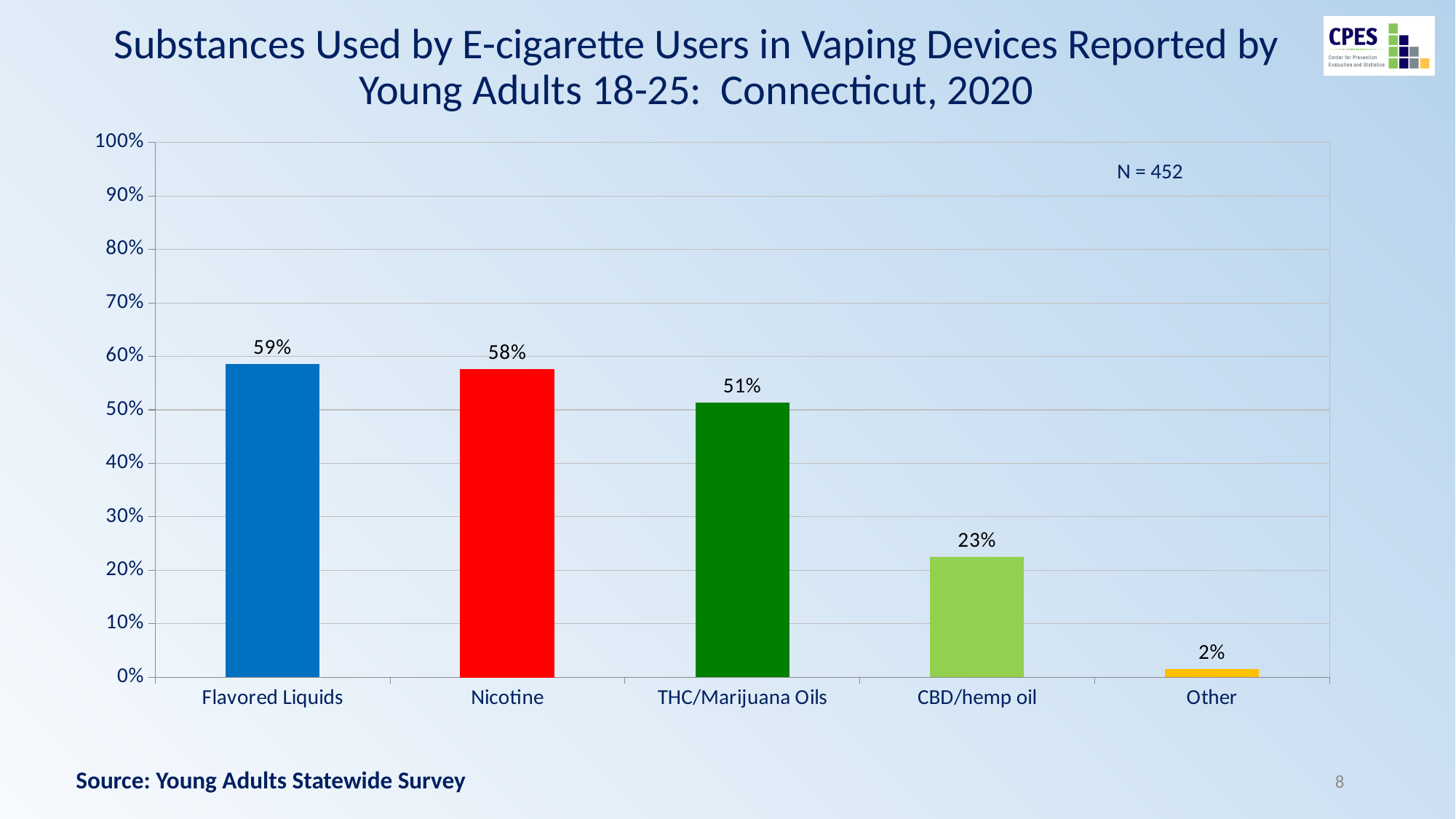
What kind of chart is shown on the slide? Bar chart What percentage of young adult e-cigarette users reported using Flavored Liquids? 59% How many substance categories are shown on the chart? 5 What is the value shown for CBD/hemp oil? 23% What is the sample size (N) shown on the chart? N = 452 What is the difference in percentage points between Flavored Liquids and Other? 57 What is the value shown for THC/Marijuana Oils? 51% Which substance has the lowest reported percentage? Other What is the difference in percentage points between THC/Marijuana Oils and CBD/hemp oil? 28 Is the value for CBD/hemp oil greater or less than 30%? less What percentage reported using Nicotine in vaping devices? 58% Which is larger, the value for THC/Marijuana Oils or the value for CBD/hemp oil? THC/Marijuana Oils